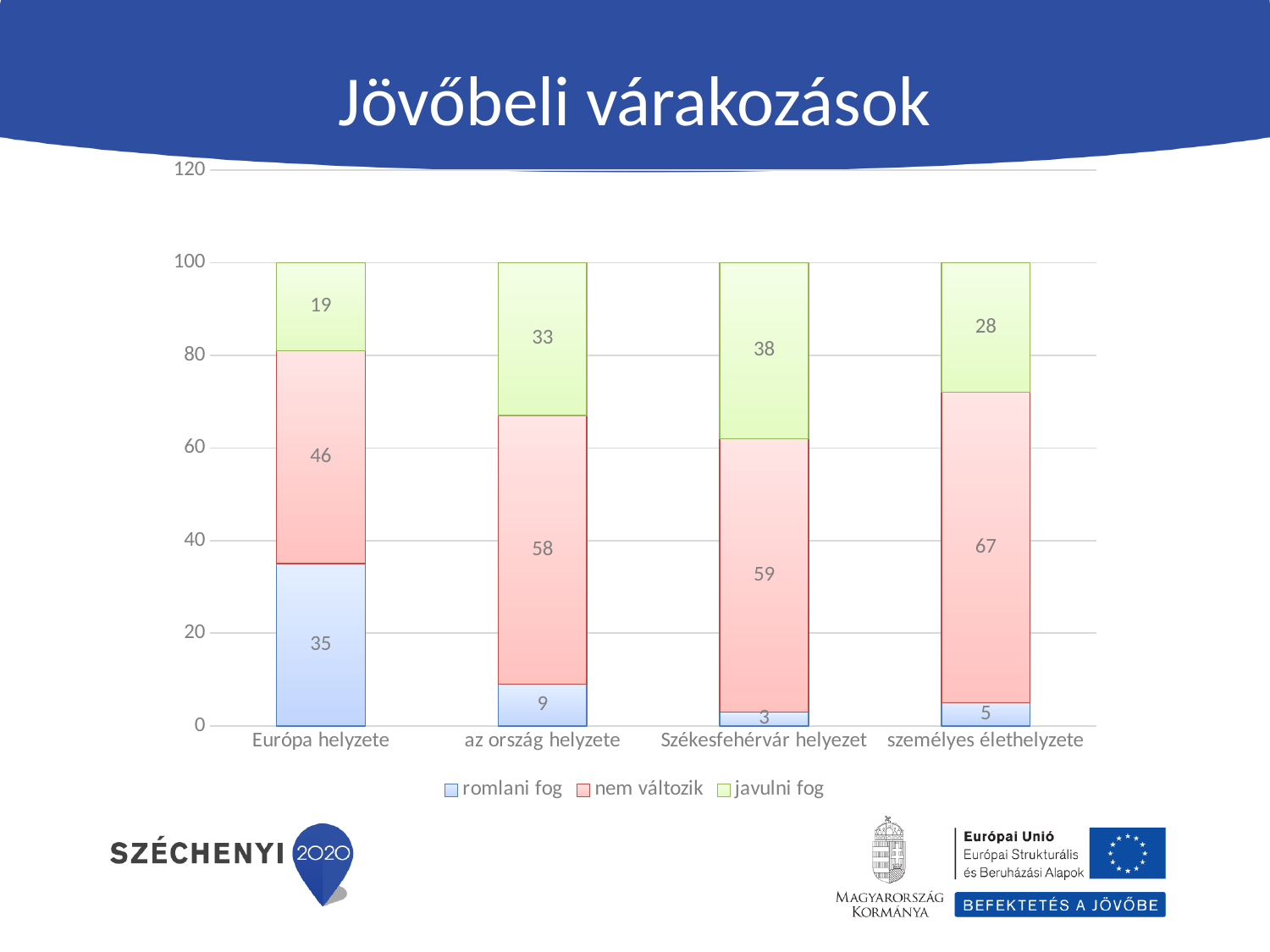
How many series does the legend list? 3 What is the title of the slide? Jövőbeli várakozások What is the value of "javulni fog" for "Székesfehérvár helyzet"? 38 What kind of chart is shown on the slide? Stacked bar chart What is the value of "nem változik" for "személyes élethelyzete"? 67 Which is larger: the "javulni fog" value for "az ország helyzete" or for "személyes élethelyzete"? az ország helyzete Which category has the highest value for "romlani fog"? Európa helyzete What is the total of the stacked bar for "az ország helyzete"? 100 What is the difference between the "nem változik" values for "személyes élethelyzete" and "Európa helyzete"? 21 What is the value of "romlani fog" for "Európa helyzete"? 35 Which category has the lowest value for "javulni fog"? Európa helyzete How many categories are shown on the x axis? 4